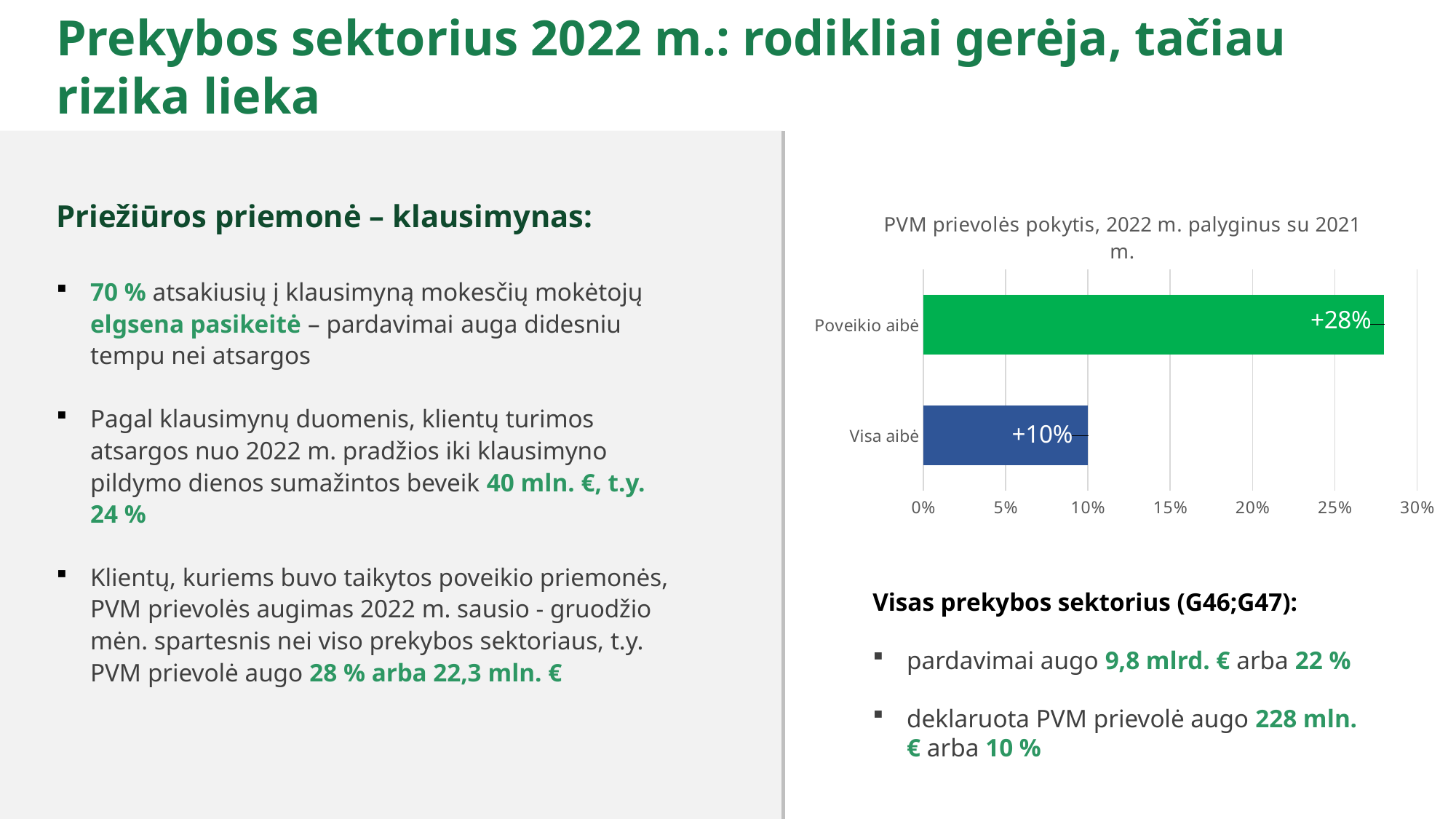
Which category has the lowest value? Visa aibė What is the title of the chart? PVM prievolės pokytis, 2022 m. palyginus su 2021 m. Which is larger, the value for Poveikio aibė or the value for Visa aibė? Poveikio aibė How many categories are shown in the chart? 2 Which category has the highest value? Poveikio aibė What kind of chart is shown on the slide? bar chart What is the difference between the values for Poveikio aibė and Visa aibė? 18% Is the value for Poveikio aibė greater or less than 25%? greater Is the value for Visa aibė greater or less than 15%? less What is the value for Poveikio aibė? +28% What is the value for Visa aibė? +10% What colour is the bar for Visa aibė? blue